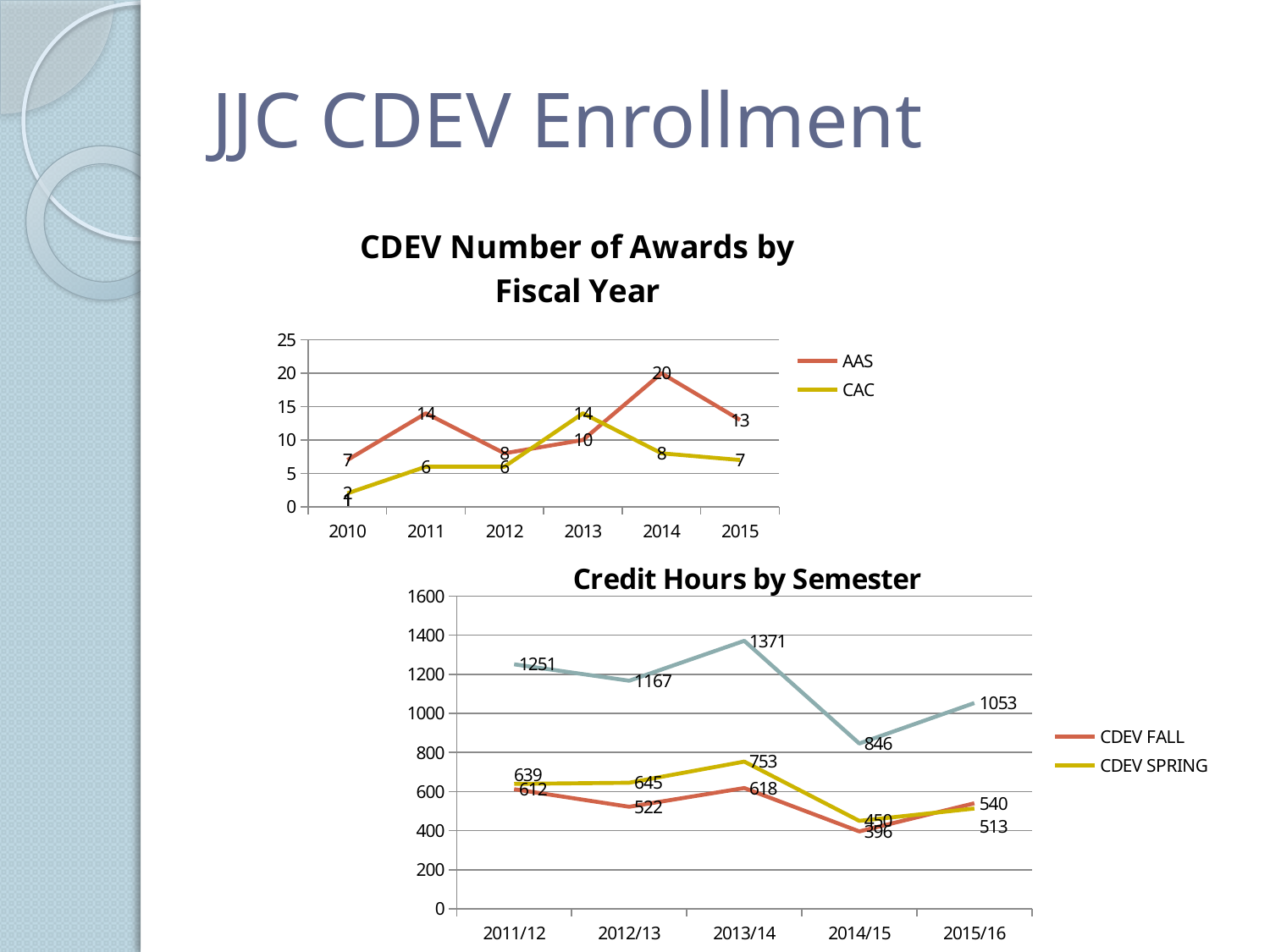
In the 'CDEV Number of Awards by Fiscal Year' chart, what is the difference between the AAS and CAC values in 2015? 6 In the 'CDEV Number of Awards by Fiscal Year' chart, how many fiscal years are shown on the x axis? 6 In the 'Credit Hours by Semester' chart, what is the CDEV FALL value for 2012/13? 522 In the 'Credit Hours by Semester' chart, which is larger in 2013/14: CDEV FALL or CDEV SPRING? CDEV SPRING In the 'Credit Hours by Semester' chart, what is the CDEV SPRING value for 2013/14? 753 In the 'Credit Hours by Semester' chart, which semester has the lowest CDEV FALL value? 2014/15 In the 'CDEV Number of Awards by Fiscal Year' chart, what is the AAS value for 2014? 20 In the 'CDEV Number of Awards by Fiscal Year' chart, which year has the highest AAS value? 2014 In the 'Credit Hours by Semester' chart, what is the difference between the CDEV SPRING and CDEV FALL values in 2011/12? 27 In the 'CDEV Number of Awards by Fiscal Year' chart, how many series does the legend list? 2 What kind of chart is 'Credit Hours by Semester'? Line chart In the 'CDEV Number of Awards by Fiscal Year' chart, what is the CAC value for 2013? 14